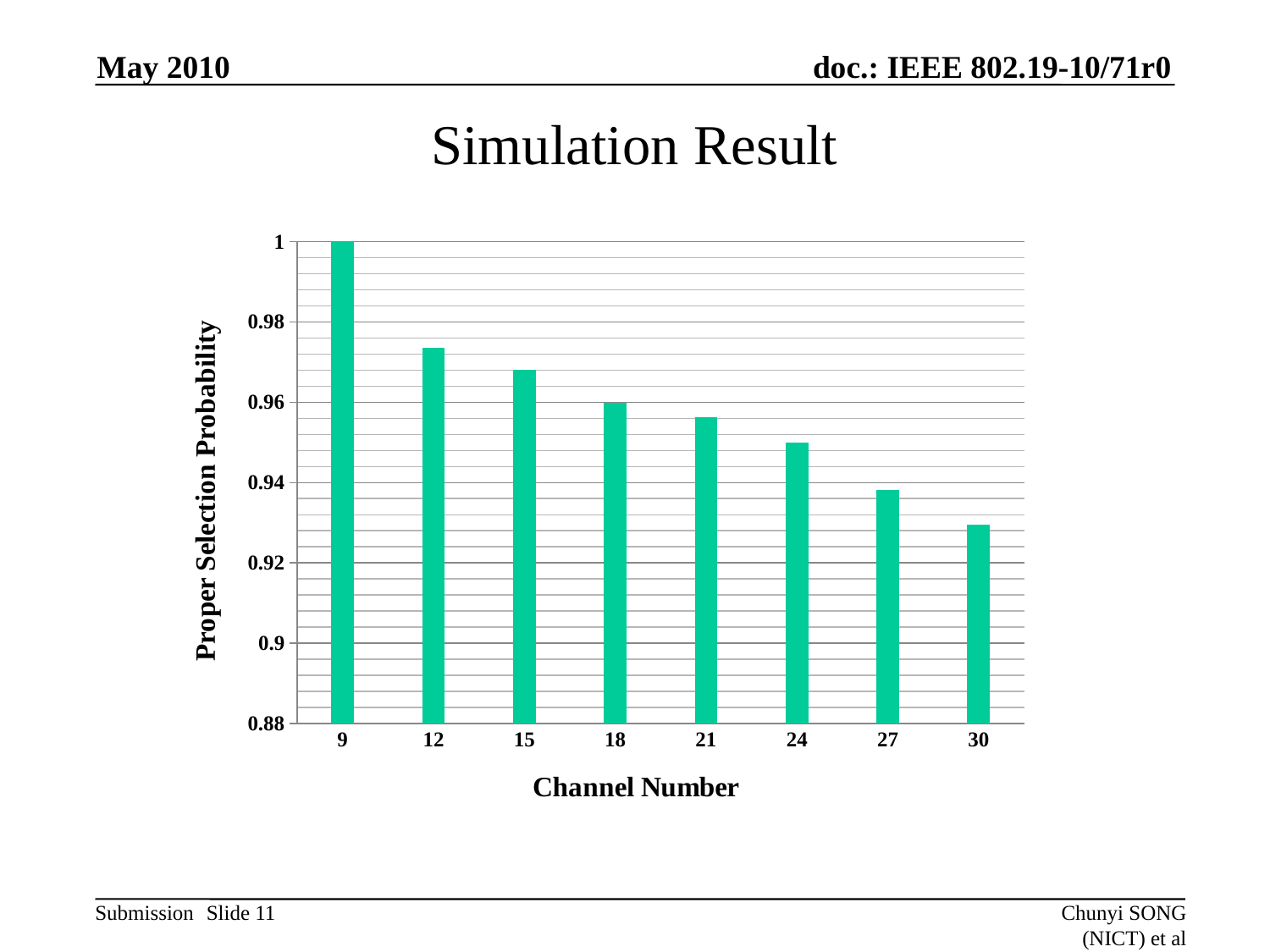
Do the values rise or fall as the channel number increases along the x axis? fall What is the proper selection probability for channel number 9? 1 Is the value for channel number 12 greater or less than 0.96? greater How many channel numbers are plotted on the x axis? 8 Is the value for channel number 24 greater or less than 0.96? less What kind of chart is shown on the slide? bar chart Which channel number has the lowest proper selection probability? 30 Is the value for channel number 27 greater or less than 0.92? greater What is the title of the vertical axis? Proper Selection Probability Which channel number has the highest proper selection probability? 9 Which has the larger proper selection probability, channel number 15 or channel number 27? 15